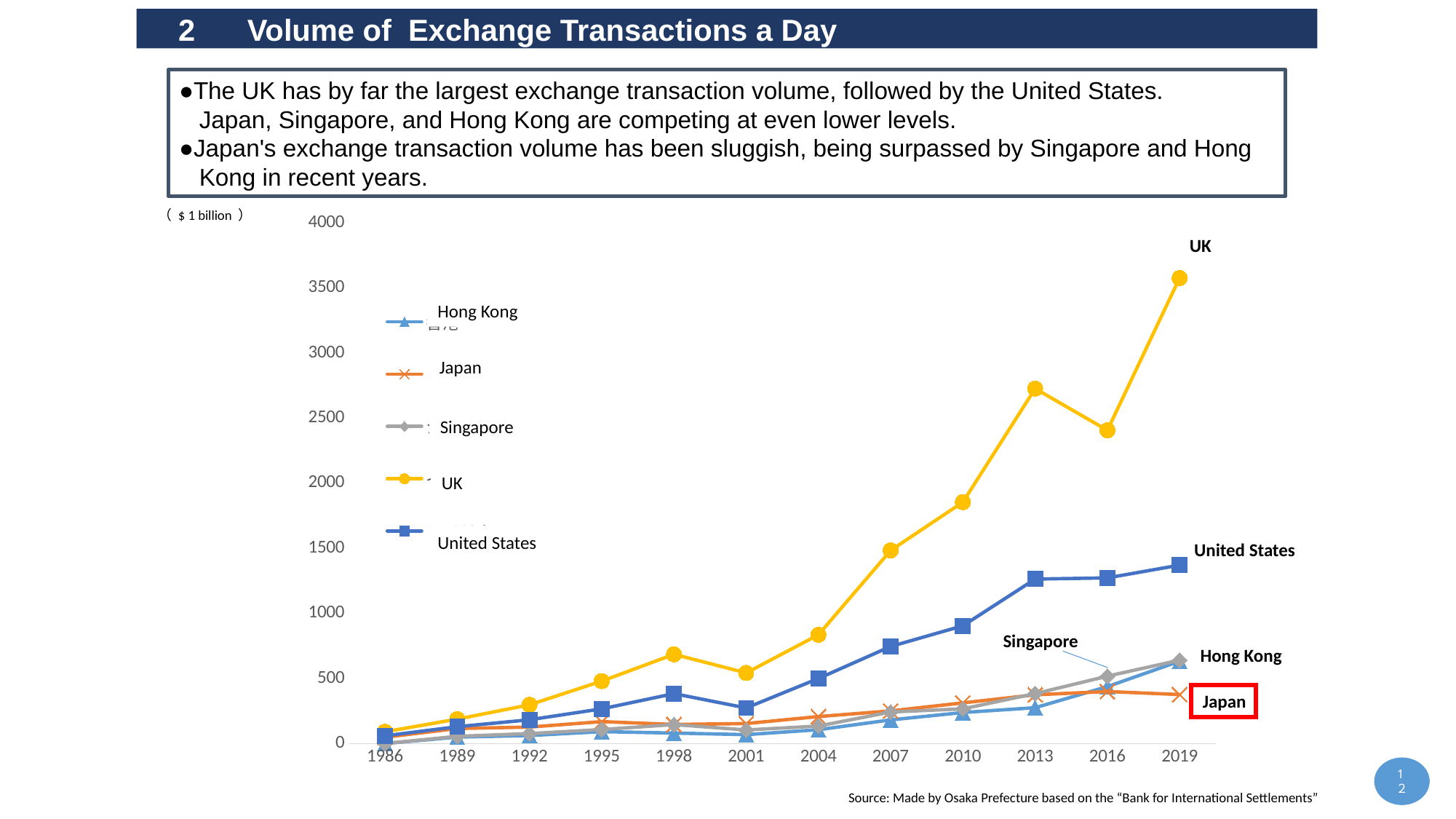
Is the value for Japan in 2019 greater or less than 500? less How many years are plotted along the x axis? 12 Which series has the lowest value in 2019? Japan Is the value for the United States in 2019 greater or less than 1500? less Is the value for the UK in 2013 greater or less than 2500? greater Which series has the highest value in 2019? UK In 2019, which is larger, the value for Singapore or the value for Japan? Singapore What kind of chart is shown on the slide? line chart Does the value for the United States rise or fall from 1986 to 2019? rise How many series does the legend list? 5 What unit is given for the y axis of the chart? $ 1 billion